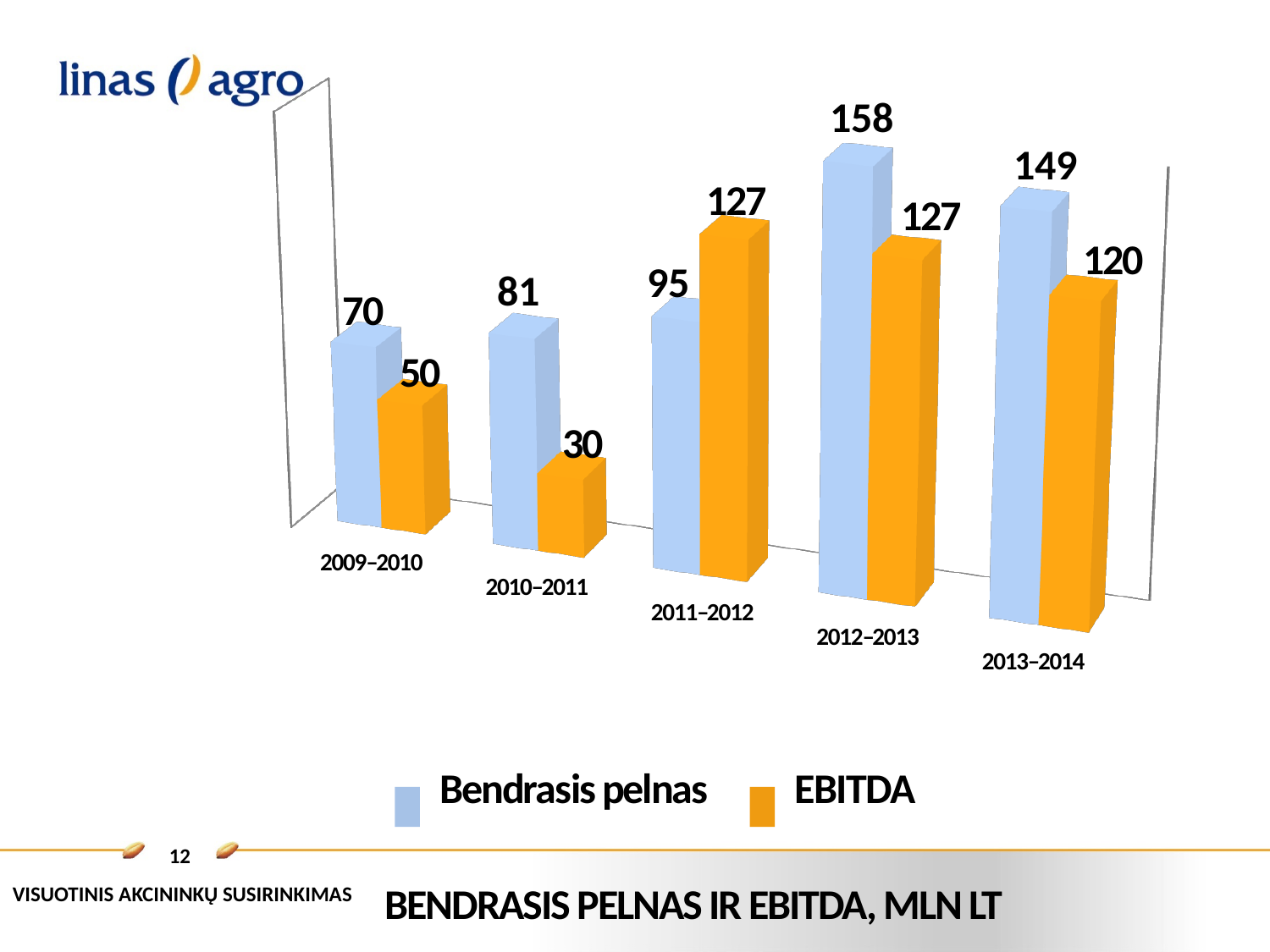
Which period has the lowest EBITDA? 2010–2011 What colour represents EBITDA in the chart? Orange What kind of chart is shown on the slide? Bar chart How many periods are shown on the x axis? 5 What is the EBITDA value for 2013–2014? 120 Does Bendrasis pelnas rise or fall from 2009–2010 to 2012–2013? Rise Which period has the highest Bendrasis pelnas? 2012–2013 What is the difference between Bendrasis pelnas and EBITDA in 2009–2010? 20 What is the Bendrasis pelnas value for 2012–2013? 158 What is the EBITDA value for 2010–2011? 30 How many series does the legend list? 2 Which is larger in 2011–2012, Bendrasis pelnas or EBITDA? EBITDA